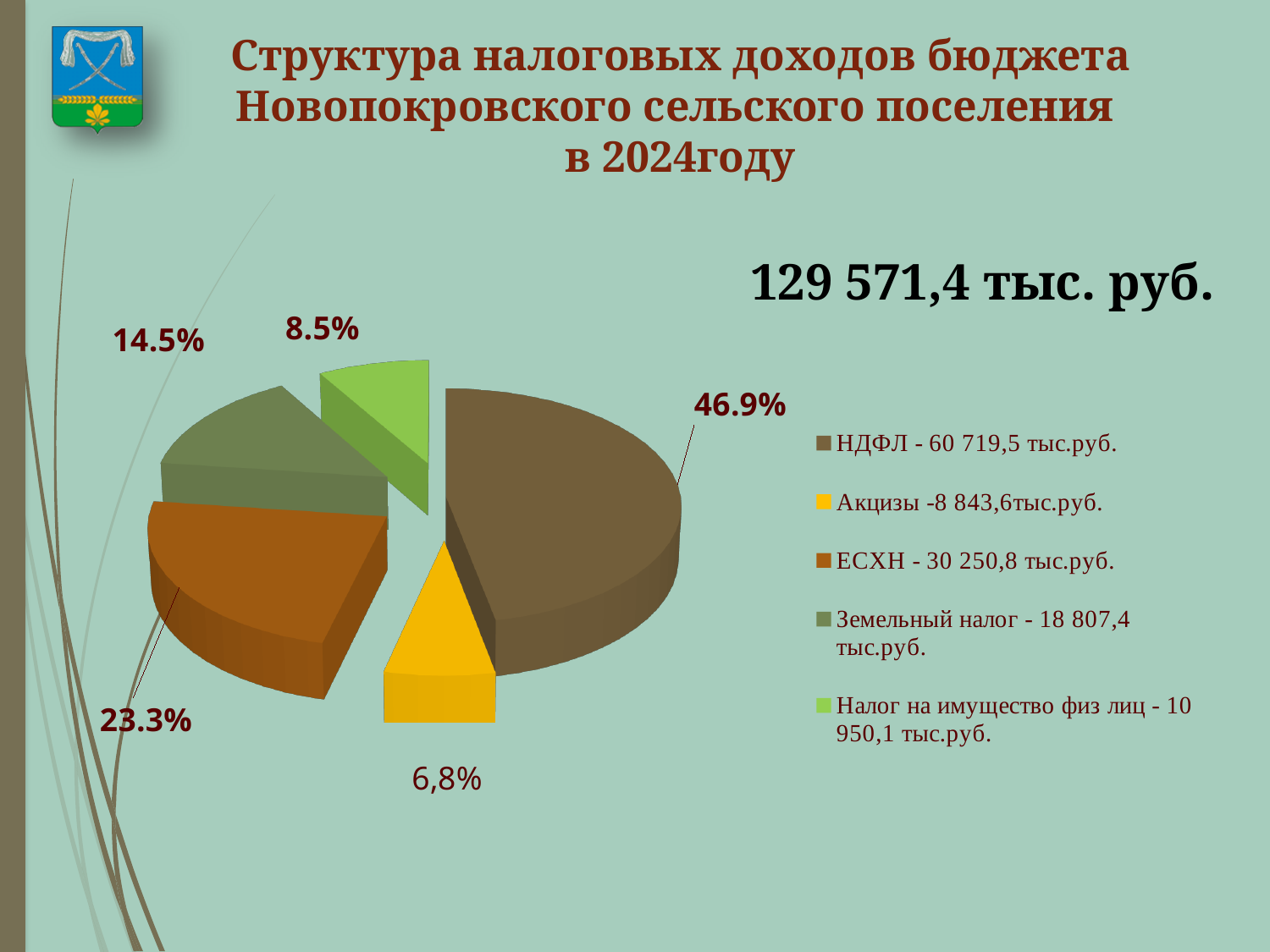
How many slices does the pie chart have? 5 Which is larger, the value for ЕСХН or the value for Земельный налог? ЕСХН What share of the pie does Земельный налог account for? 14.5% What kind of chart is shown on the slide? Pie chart How many entries does the legend list? 5 What share of the pie does НДФЛ account for? 46.9% Which category has the largest share of the pie? НДФЛ What is the difference between the value for НДФЛ and the value for ЕСХН, in тыс.руб.? 30 468,7 What value is given in the legend for Налог на имущество физ лиц? 10 950,1 тыс.руб. Which category has the smallest share of the pie? Акцизы What share of the pie does ЕСХН account for? 23.3% What total amount is shown on the slide for the tax revenues? 129 571,4 тыс. руб.